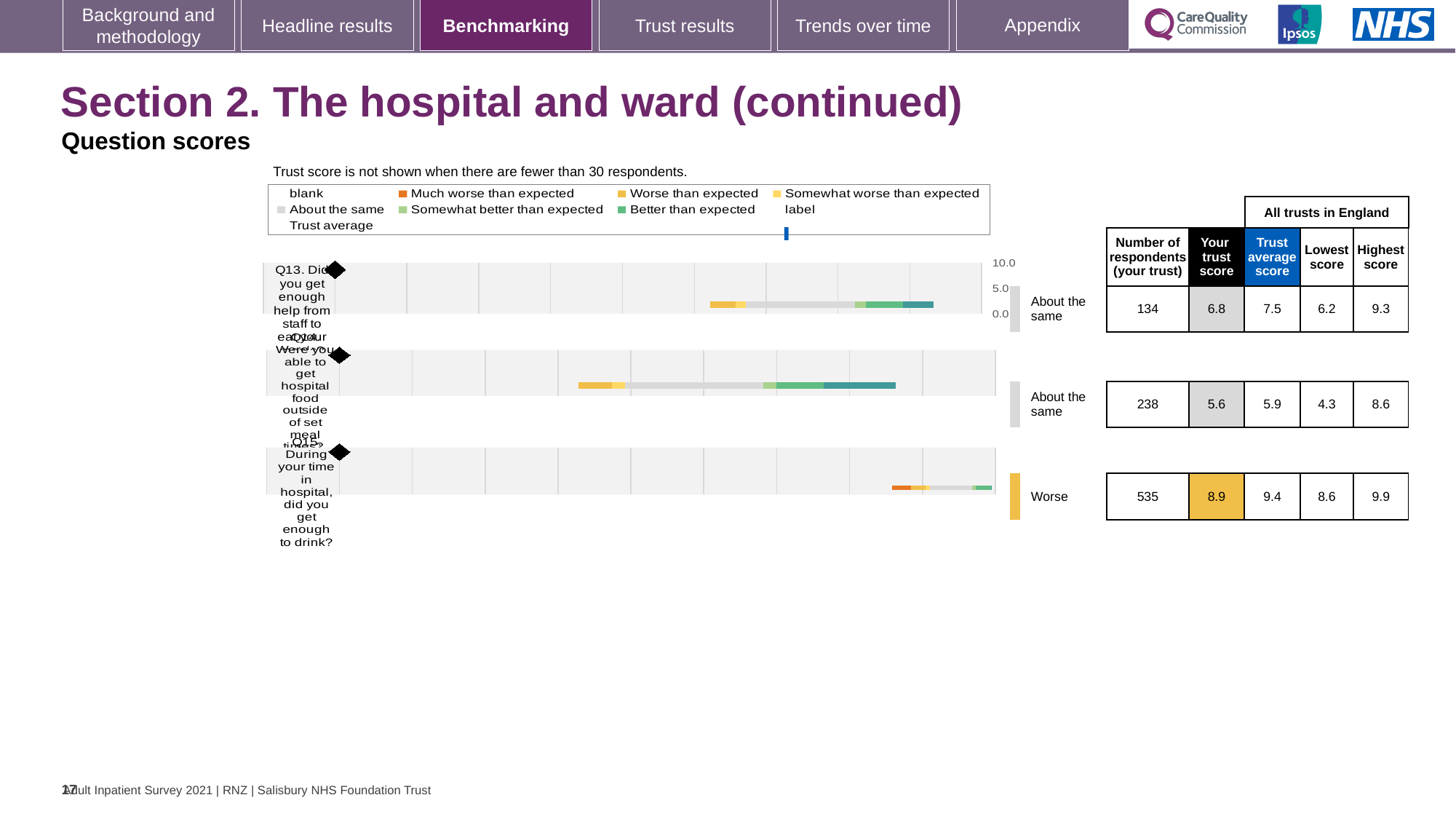
What is the trust score for Q13 (Did you get enough help from staff to eat your meals?)? 6.8 What kind of chart is used to show the question scores on this slide? bar chart What is the trust score for Q15 (During your time in hospital, did you get enough to drink?)? 8.9 How many respondents answered Q15 at this trust? 535 What is the trust score for Q14 (Were you able to get hospital food outside of set meal times?)? 5.6 What benchmark category is shown for Q15? Worse For Q13, which is larger: the trust score or the trust average score for all trusts in England? Trust average score Which question has the lowest trust score? Q14 Which question has the highest trust score? Q15 How many questions are plotted in the chart? 3 What is the difference between the trust scores for Q15 and Q13? 2.1 What is the highest score across all trusts in England for Q14? 8.6